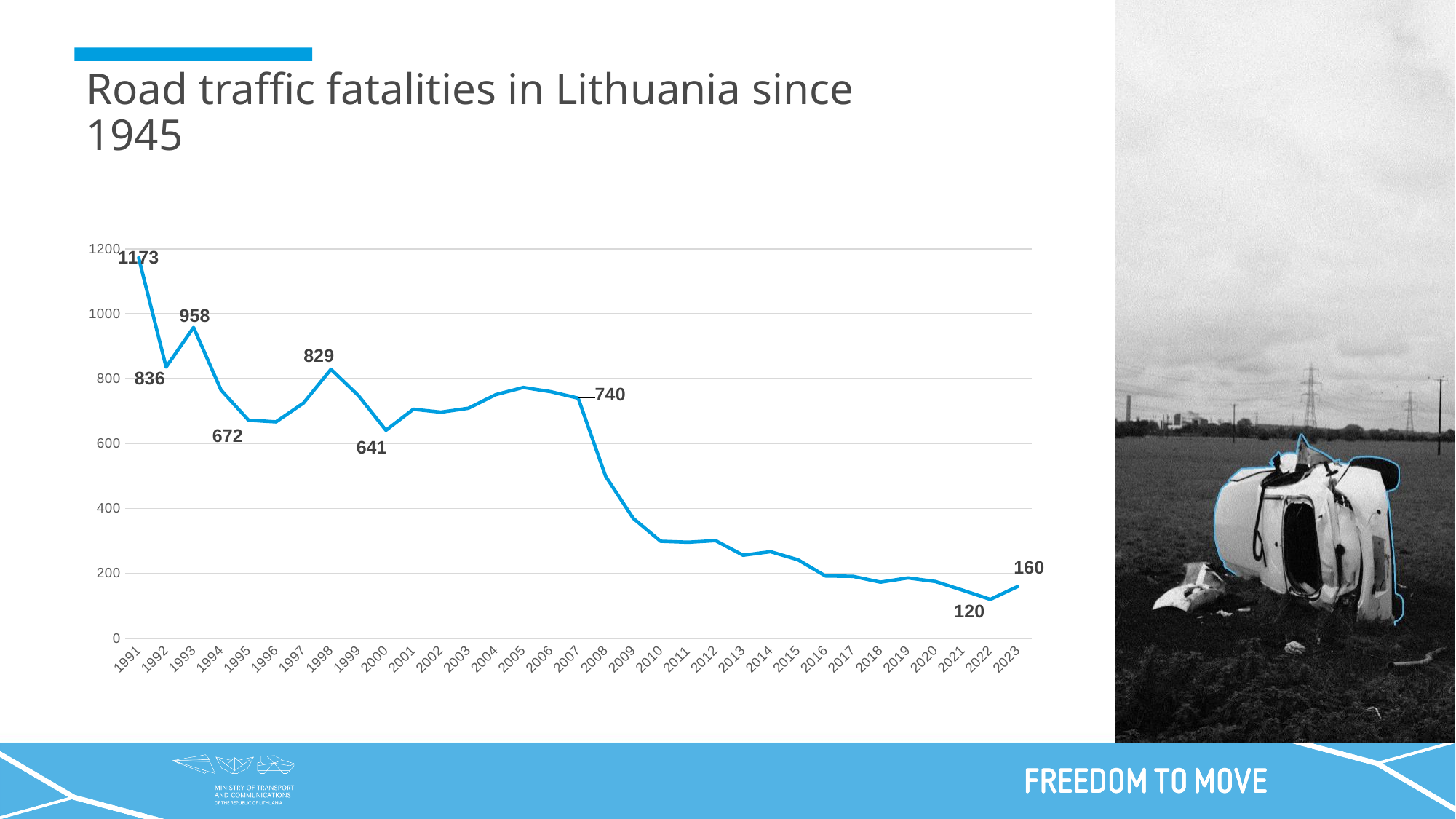
Is the value for 2010 greater or less than 400? less What is the value for 1993? 958 What is the value for 1991? 1173 What type of chart is shown on the slide? line chart What is the value for 2007? 740 Which year has the lowest value? 2022 Overall, do the values rise or fall from 1991 to 2023? fall What is the title of the chart on the slide? Road traffic fatalities in Lithuania since 1945 What is the difference between the values for 1991 and 2023? 1013 Which year has the highest value? 1991 Which is larger, the value for 1998 or the value for 2000? 1998 What is the value for 2022? 120